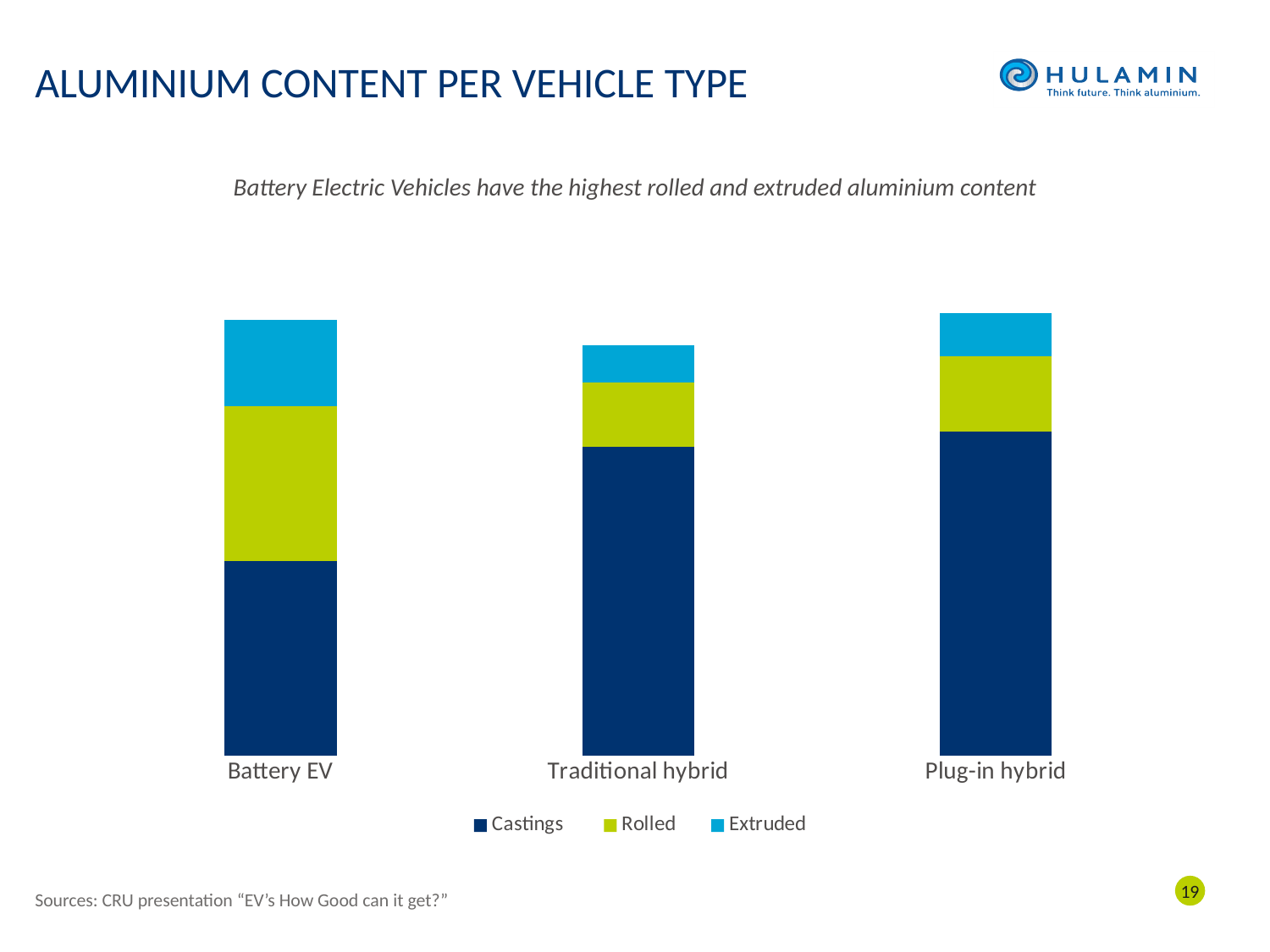
Is the Castings segment larger for Battery EV or for Plug-in hybrid? Plug-in hybrid Which vehicle type has the smallest Castings segment? Battery EV Which vehicle type has the largest Rolled segment? Battery EV How many vehicle types are shown on the x axis of the chart? 3 What is the title of the slide containing the chart? ALUMINIUM CONTENT PER VEHICLE TYPE Is the Rolled segment larger for Battery EV or for Traditional hybrid? Battery EV How many series does the chart's legend list? 3 What kind of chart is shown on the slide? Stacked bar chart Which vehicle type has the shortest total bar? Traditional hybrid Which vehicle type has the largest Extruded segment? Battery EV Is the Extruded segment larger for Battery EV or for Plug-in hybrid? Battery EV What are the three series listed in the chart's legend? Castings, Rolled, Extruded